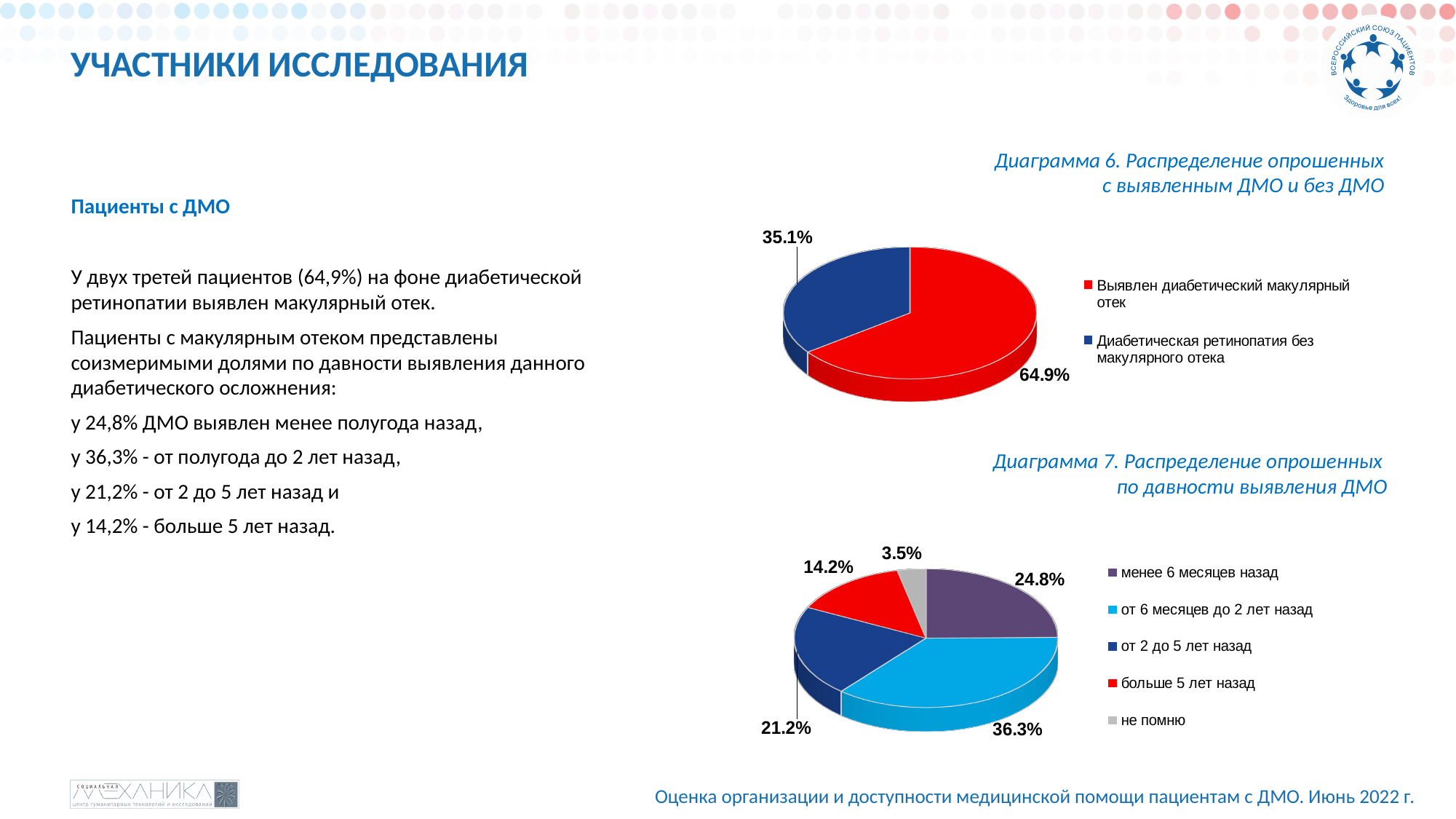
In Diagram 6 (Распределение опрошенных с выявленным ДМО и без ДМО), what share of respondents had diabetic macular edema detected (Выявлен диабетический макулярный отек)? 64.9% How many slices does the pie in Diagram 7 have? 5 In Diagram 7, what is the difference between the share for 'от 2 до 5 лет назад' and the share for 'больше 5 лет назад'? 7.0% In Diagram 7 (Распределение опрошенных по давности выявления ДМО), what share of respondents had DMO detected from 6 months to 2 years ago? 36.3% In Diagram 6, what is the difference between the share with detected macular edema and the share without it? 29.8% In Diagram 6, what share of respondents had diabetic retinopathy without macular edema? 35.1% In Diagram 7, which category has the smallest share? не помню In Diagram 7, which is larger: the share for 'менее 6 месяцев назад' or the share for 'от 2 до 5 лет назад'? менее 6 месяцев назад In Diagram 7, which category has the largest share? от 6 месяцев до 2 лет назад In Diagram 7, what share of respondents answered 'не помню' (don't remember)? 3.5% What type of chart is Diagram 6? Pie chart How many entries does the legend of Diagram 6 list? 2